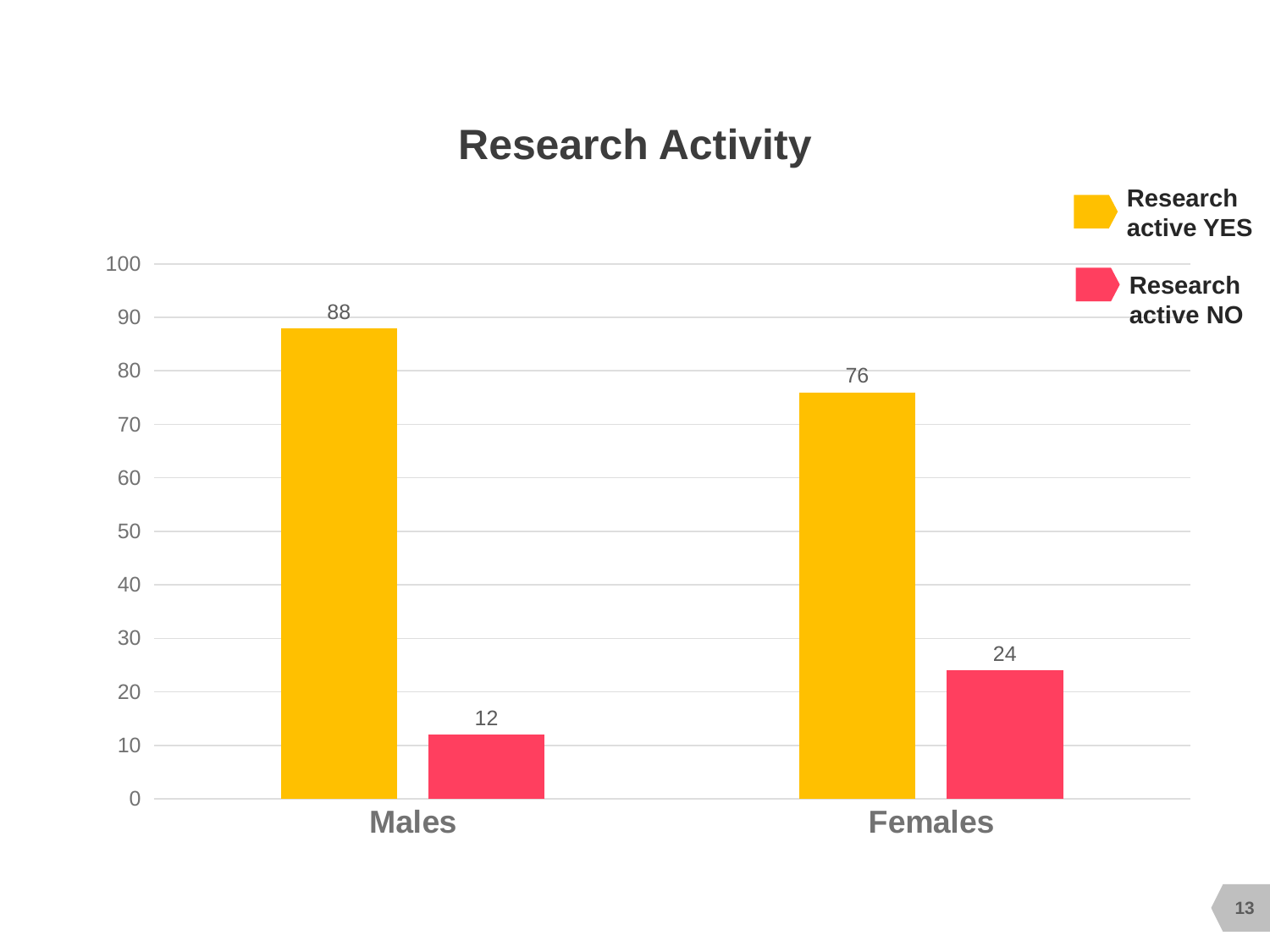
What is the value for Research active NO for Females? 24 Is the value for Research active YES for Females greater or less than 70? greater How many categories are shown on the x axis? 2 What is the difference between the Research active YES values for Males and Females? 12 Which category has the highest Research active YES value? Males What is the value for Research active YES for Males? 88 What is the value for Research active NO for Males? 12 What kind of chart is shown on the slide? bar chart What is the value for Research active YES for Females? 76 Which is larger: Research active NO for Females or Research active NO for Males? Females How many series does the legend list? 2 Which category has the lowest Research active NO value? Males